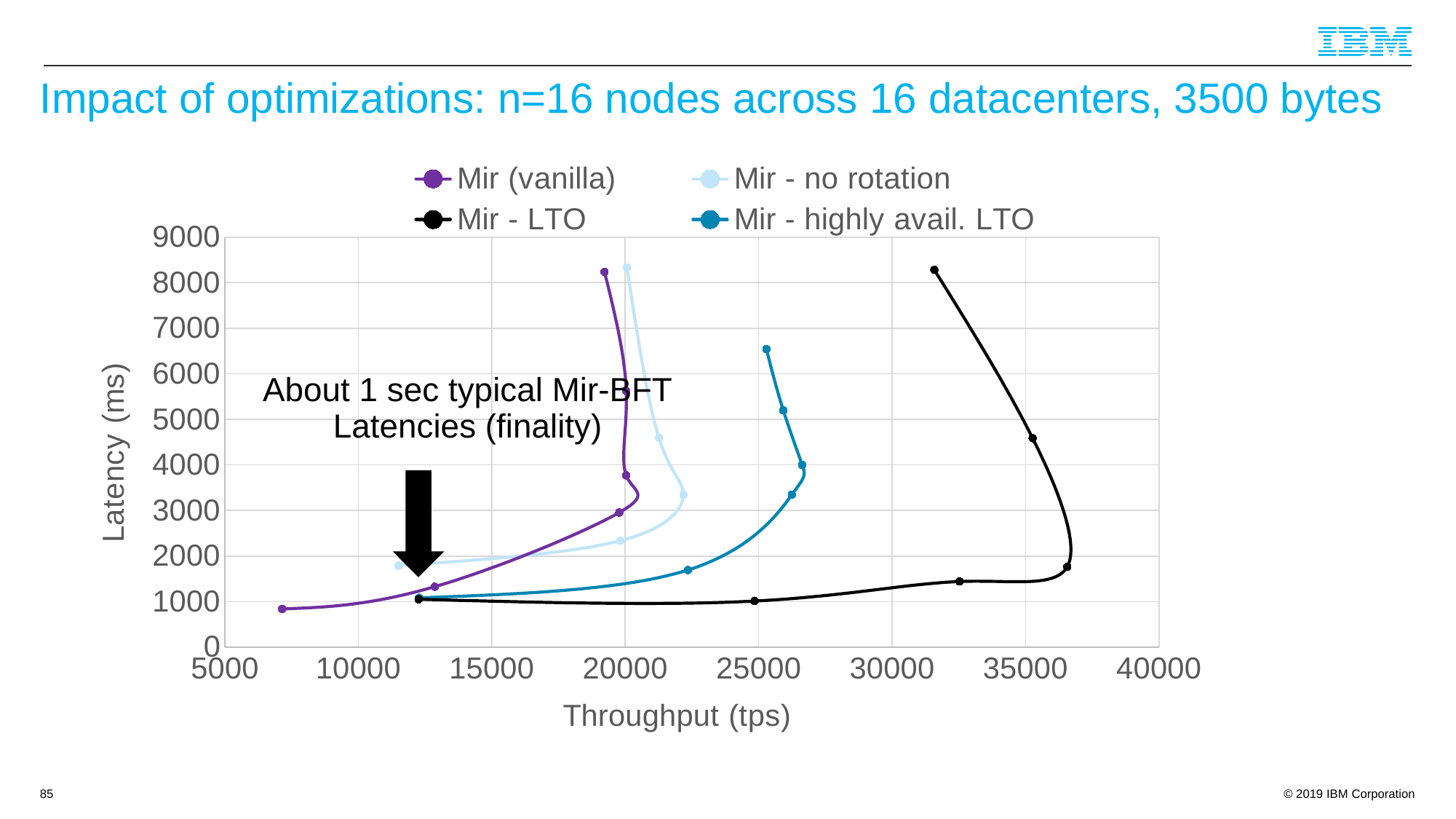
Is the highest latency of Mir - highly avail. LTO greater or less than 7000? less Is the lowest throughput point of Mir (vanilla) greater or less than 10000? less Is the highest throughput reached by Mir - LTO greater or less than 35000? greater Which series reaches a higher throughput, Mir - highly avail. LTO or Mir (vanilla)? Mir - highly avail. LTO Which series has the lowest maximum latency? Mir - highly avail. LTO Which series has the point with the lowest throughput? Mir (vanilla) What kind of chart is shown on the slide? line chart What is the title of the chart on the slide? Impact of optimizations: n=16 nodes across 16 datacenters, 3500 bytes What is the label of the x axis? Throughput (tps) How many series does the legend list? 4 Which series reaches the highest throughput? Mir - LTO